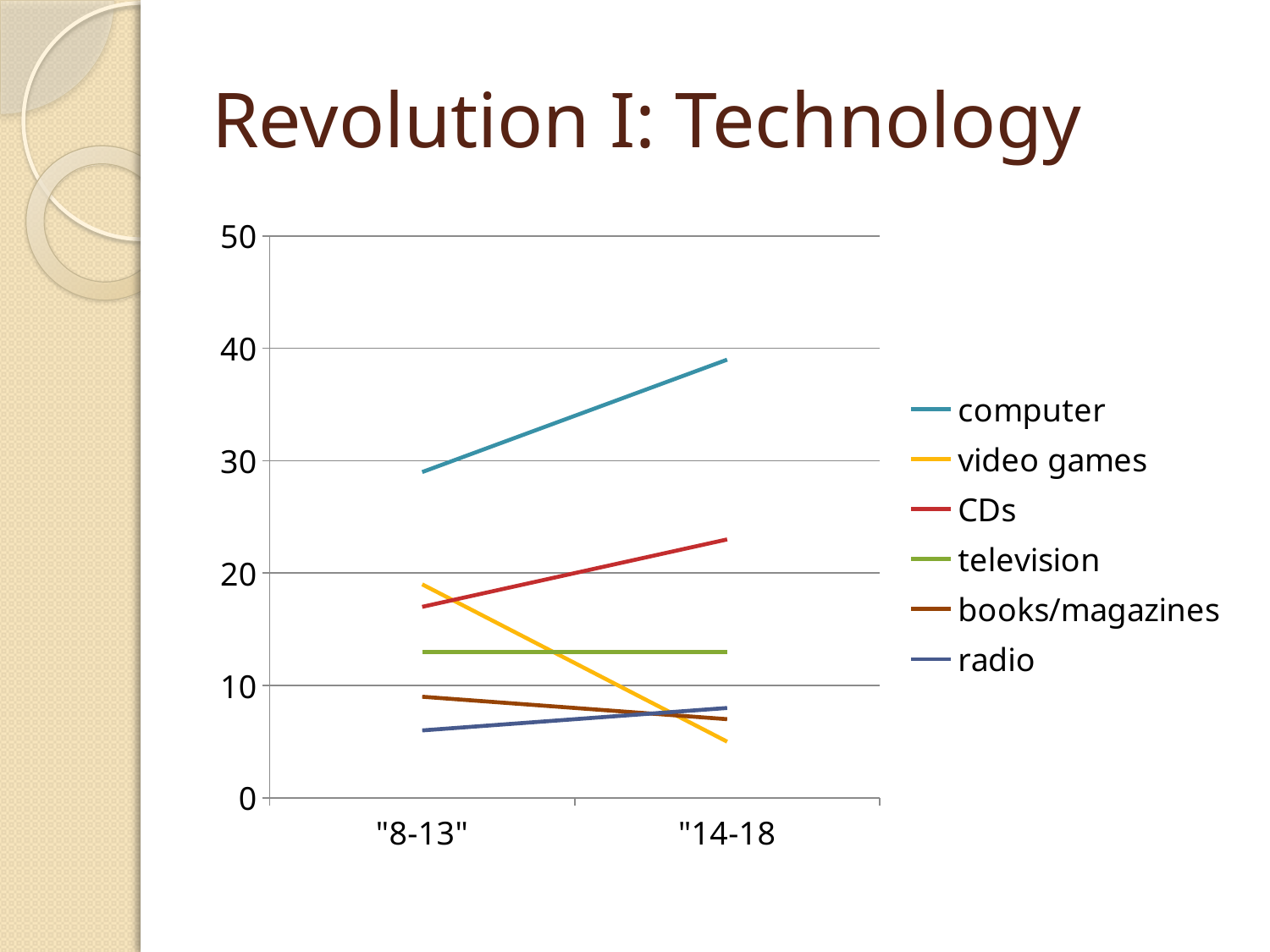
Does the computer series rise or fall from "8-13" to "14-18"? rise Is the value for video games at "14-18" greater or less than 10? less Which series has the lowest value for the "14-18" category? video games For the "8-13" category, which is larger: video games or CDs? video games Which series has the highest value for the "14-18" category? computer What kind of chart is shown on the slide? line chart What is the title of the slide? Revolution I: Technology Which series has the lowest value for the "8-13" category? radio Does the video games series rise or fall from "8-13" to "14-18"? fall How many series does the legend list? 6 Is the value for computer at "14-18" greater or less than 30? greater How many categories are shown on the x axis? 2